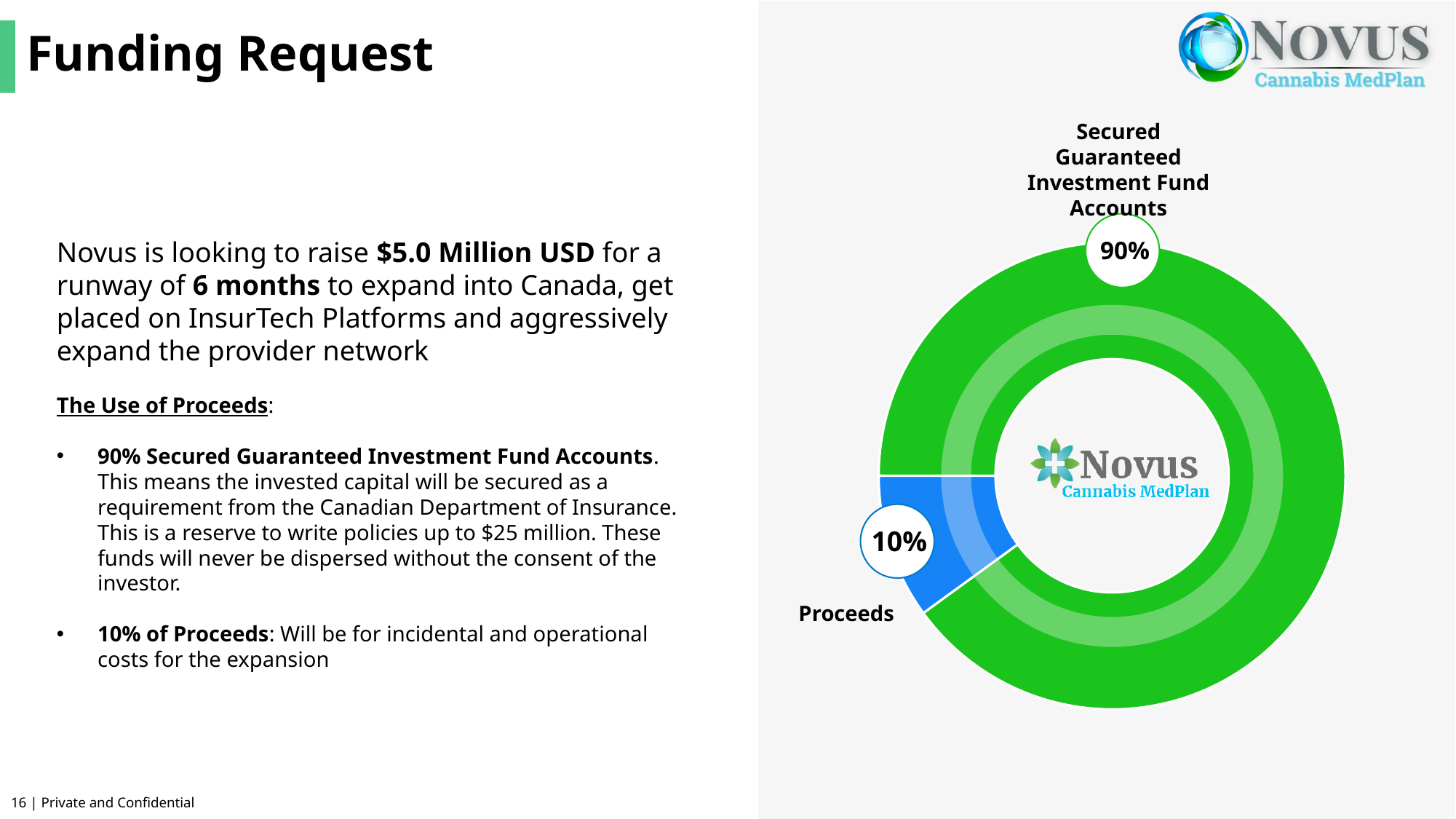
How many slices does the donut chart have? 2 What share of the donut chart is labelled Secured Guaranteed Investment Fund Accounts? 90% What colour is the Secured Guaranteed Investment Fund Accounts slice in the donut chart? Green What kind of chart is shown on the slide? Donut (pie) chart What colour is the Proceeds slice in the donut chart? Blue Which slice of the donut chart is the largest? Secured Guaranteed Investment Fund Accounts Do the two slices of the donut chart add up to 100%? Yes What share of the donut chart is labelled Proceeds? 10% Which is larger in the donut chart: Proceeds or Secured Guaranteed Investment Fund Accounts? Secured Guaranteed Investment Fund Accounts Which slice of the donut chart is the smallest? Proceeds What is the difference in percentage points between the Secured Guaranteed Investment Fund Accounts slice and the Proceeds slice? 80 percentage points